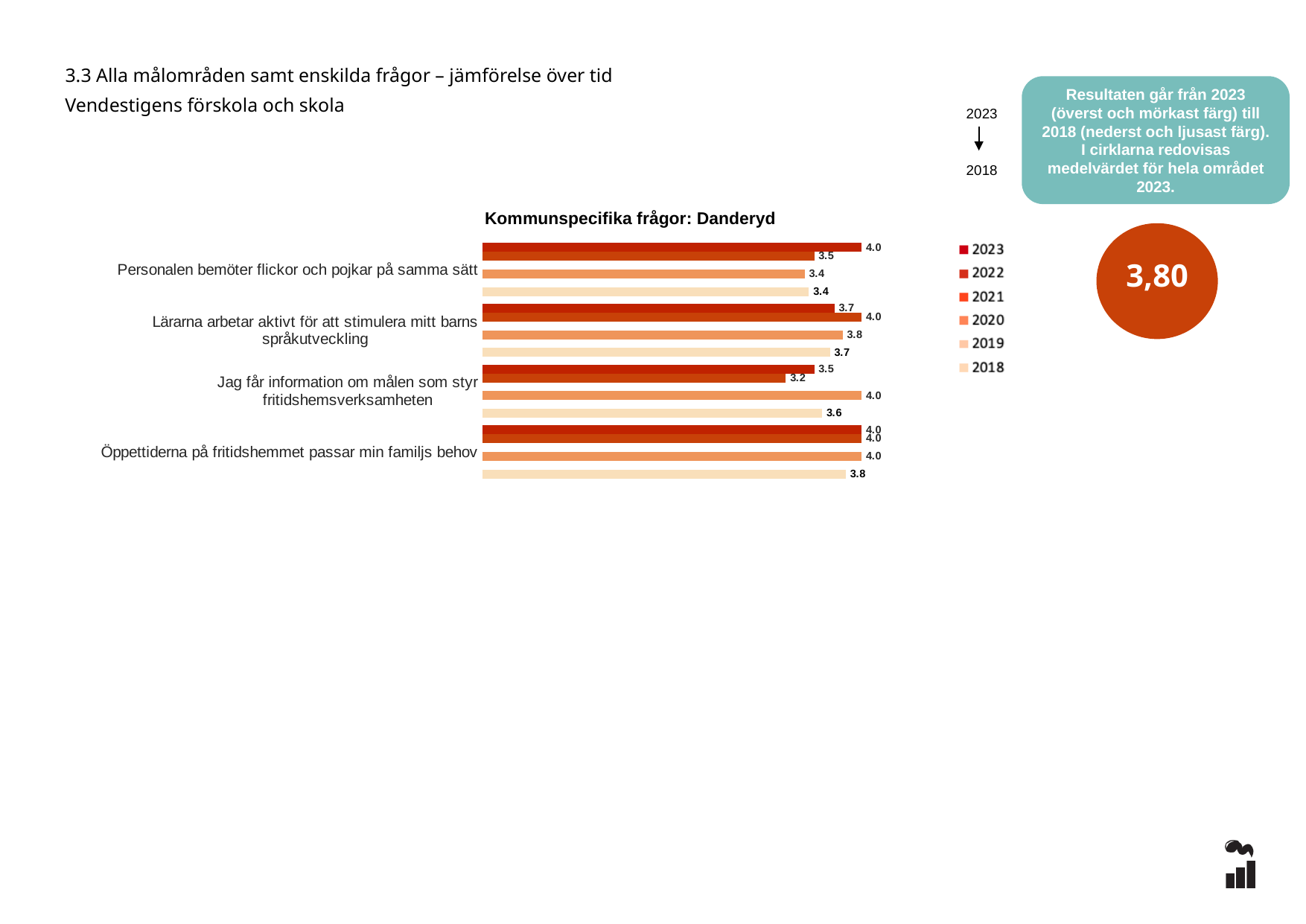
What kind of chart is shown under the title "Kommunspecifika frågor: Danderyd"? bar chart What is the 2023 value for "Lärarna arbetar aktivt för att stimulera mitt barns språkutveckling"? 3.7 What mean value for the whole area in 2023 is shown in the circle next to the chart? 3,80 Which category contains the lowest labelled value on the chart? Jag får information om målen som styr fritidshemsverksamheten What is the difference between the 2023 and 2018 values for "Personalen bemöter flickor och pojkar på samma sätt"? 0.6 How many question categories are shown on the chart? 4 Which has the higher 2023 value: "Personalen bemöter flickor och pojkar på samma sätt" or "Jag får information om målen som styr fritidshemsverksamheten"? Personalen bemöter flickor och pojkar på samma sätt What is the 2023 value for "Jag får information om målen som styr fritidshemsverksamheten"? 3.5 How many series (years) does the legend of the chart list? 6 What is the 2018 value for "Öppettiderna på fritidshemmet passar min familjs behov"? 3.8 What is the 2018 value for "Jag får information om målen som styr fritidshemsverksamheten"? 3.6 What is the 2023 value for "Personalen bemöter flickor och pojkar på samma sätt"? 4.0